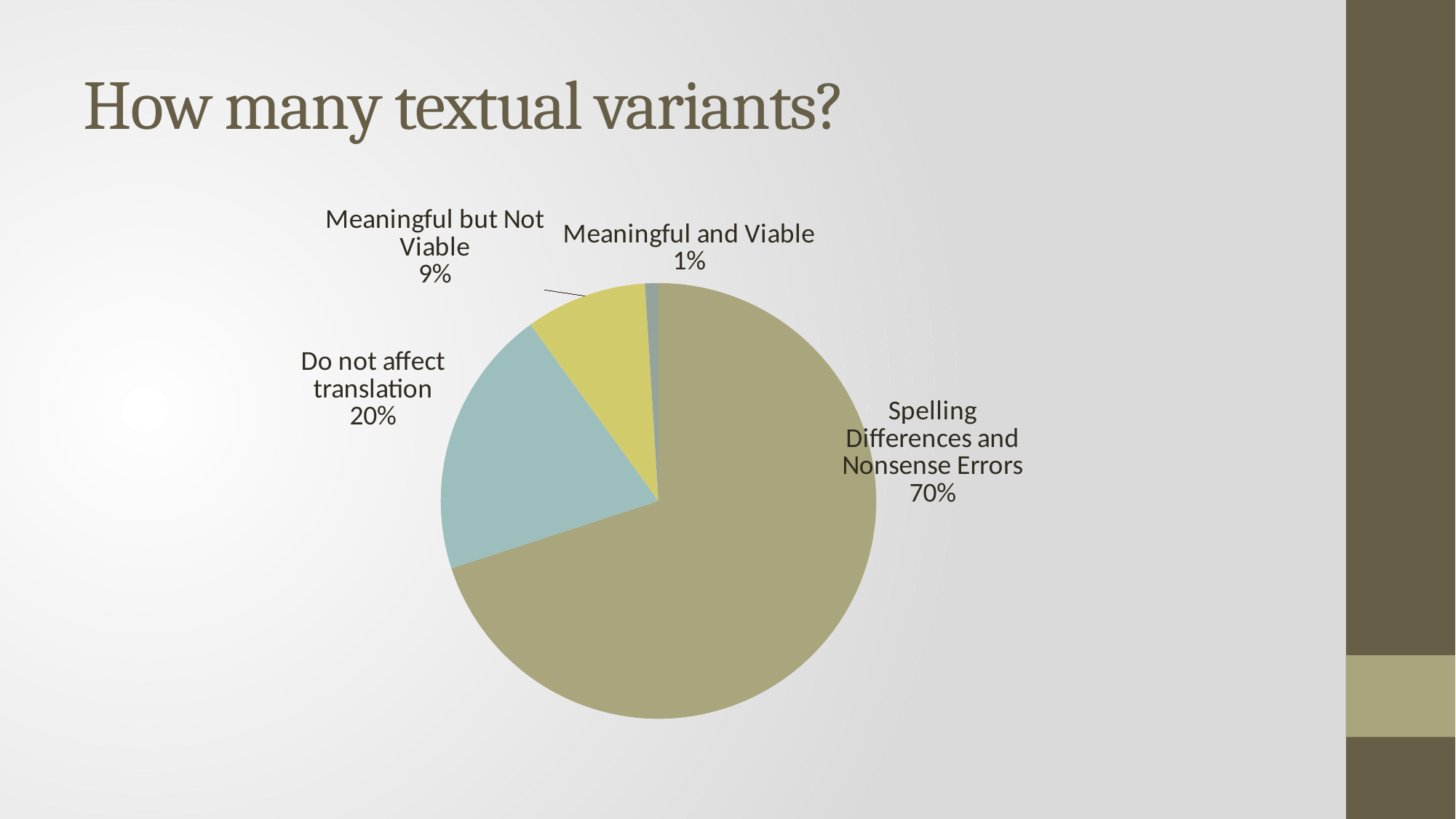
What is the difference in percentage points between 'Spelling Differences and Nonsense Errors' and 'Do not affect translation'? 50 Which is larger: 'Do not affect translation' or 'Meaningful but Not Viable'? Do not affect translation Which category has the smallest slice of the pie? Meaningful and Viable What percentage is shown for 'Do not affect translation'? 20% What percentage is shown for 'Meaningful and Viable'? 1% What percentage is shown for 'Meaningful but Not Viable'? 9% Which category has the largest slice of the pie? Spelling Differences and Nonsense Errors What kind of chart is shown on the slide? pie chart What is the difference in percentage points between 'Do not affect translation' and 'Meaningful but Not Viable'? 11 What share of the pie is labelled 'Spelling Differences and Nonsense Errors'? 70% What is the title of the slide containing the pie chart? How many textual variants? How many slices does the pie chart have? 4